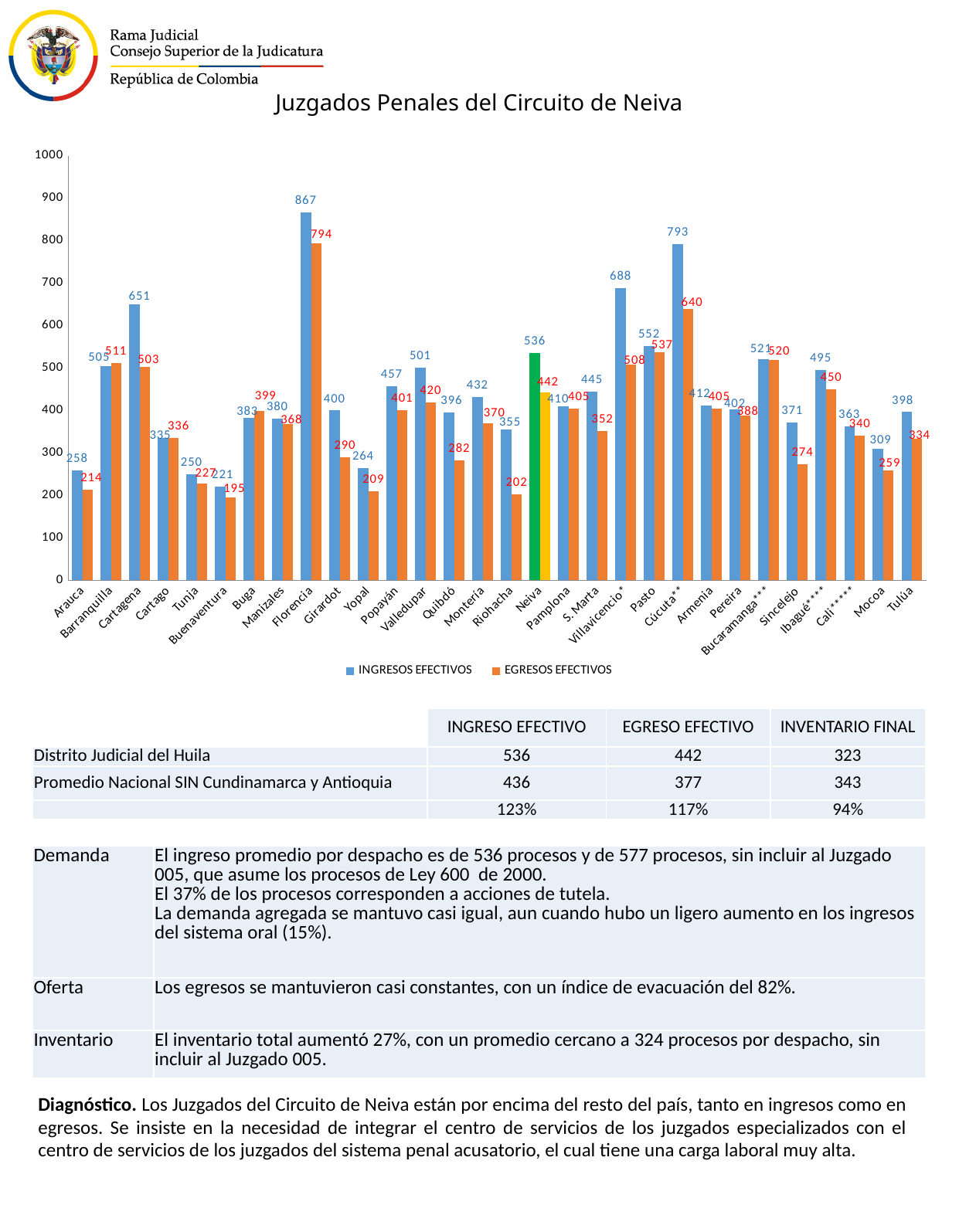
What is the INGRESOS EFECTIVOS value for Valledupar? 501 What is the INGRESOS EFECTIVOS value for Neiva? 536 Is the EGRESOS EFECTIVOS value for Riohacha greater or less than 300? less Which category has the highest INGRESOS EFECTIVOS value? Florencia What is the difference between INGRESOS EFECTIVOS and EGRESOS EFECTIVOS for Neiva? 94 How many categories are shown on the x axis of the chart? 30 What kind of chart is shown on the slide? bar chart How many series does the chart legend list? 2 Which category has the lowest EGRESOS EFECTIVOS value? Buenaventura What is the EGRESOS EFECTIVOS value for Cúcuta**? 640 What is the difference between INGRESOS EFECTIVOS and EGRESOS EFECTIVOS for Florencia? 73 Which has the larger INGRESOS EFECTIVOS value, Cartagena or Villavicencio*? Villavicencio*